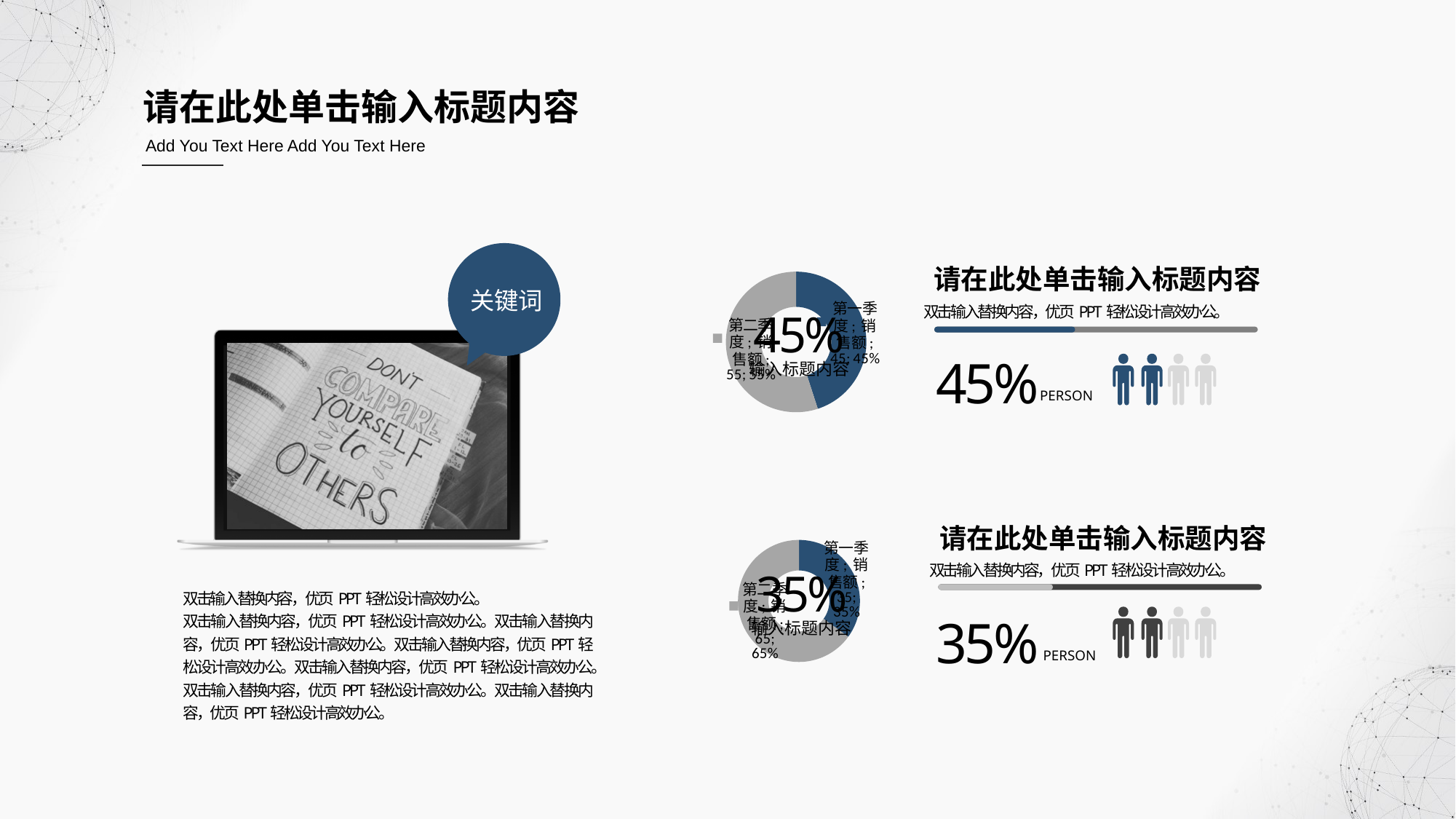
In the upper pie chart, what is the difference between the 第二季度 and 第一季度 percentages? 10% In the lower pie chart, what percentage is shown for 第二季度? 65% How many slices does the lower pie chart have? 2 In the lower pie chart, what is the difference between the 第二季度 and 第一季度 percentages? 30% In the upper pie chart, what colour is the 第一季度 slice? blue In the upper pie chart, what percentage is shown for 第一季度? 45% In the lower pie chart, what percentage is shown for 第一季度? 35% What kind of chart is the upper chart on the slide? doughnut chart In the upper pie chart, what percentage is shown for 第二季度? 55% In the upper pie chart, which quarter has the larger slice? 第二季度 Is the 第一季度 slice larger in the upper pie chart or the lower pie chart? upper pie chart In the lower pie chart, which quarter has the smaller slice? 第一季度